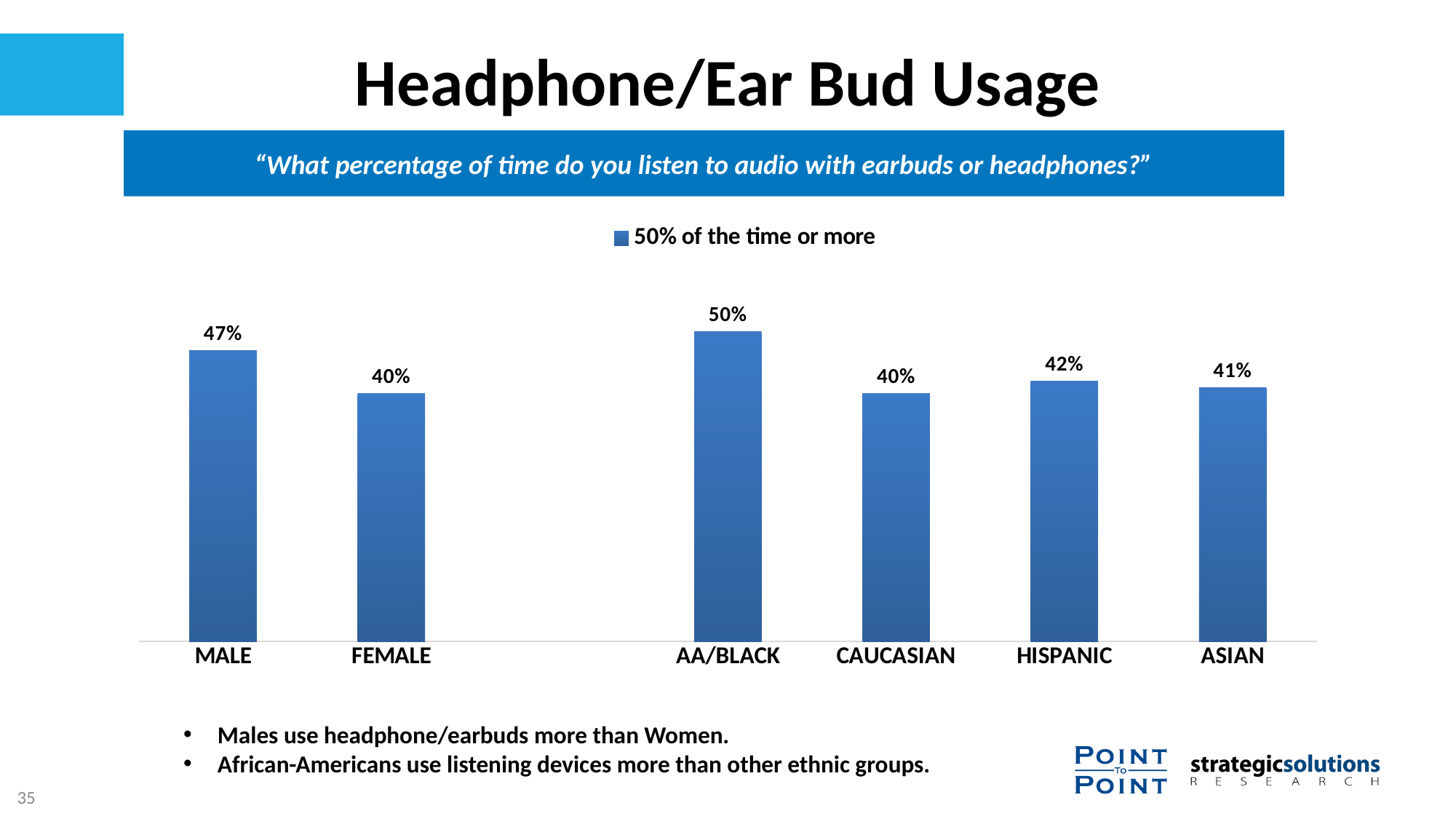
What series does the legend list? 50% of the time or more What is the value for ASIAN? 41% What is the difference between the MALE and FEMALE values? 7% Which category has the highest value? AA/BLACK What is the value for AA/BLACK? 50% What is the value for MALE? 47% What is the value for FEMALE? 40% What kind of chart is shown on the slide? Bar chart Which is larger, the value for MALE or the value for FEMALE? MALE What is the value for HISPANIC? 42% How many categories are shown on the x axis? 6 What is the difference between the AA/BLACK and CAUCASIAN values? 10%